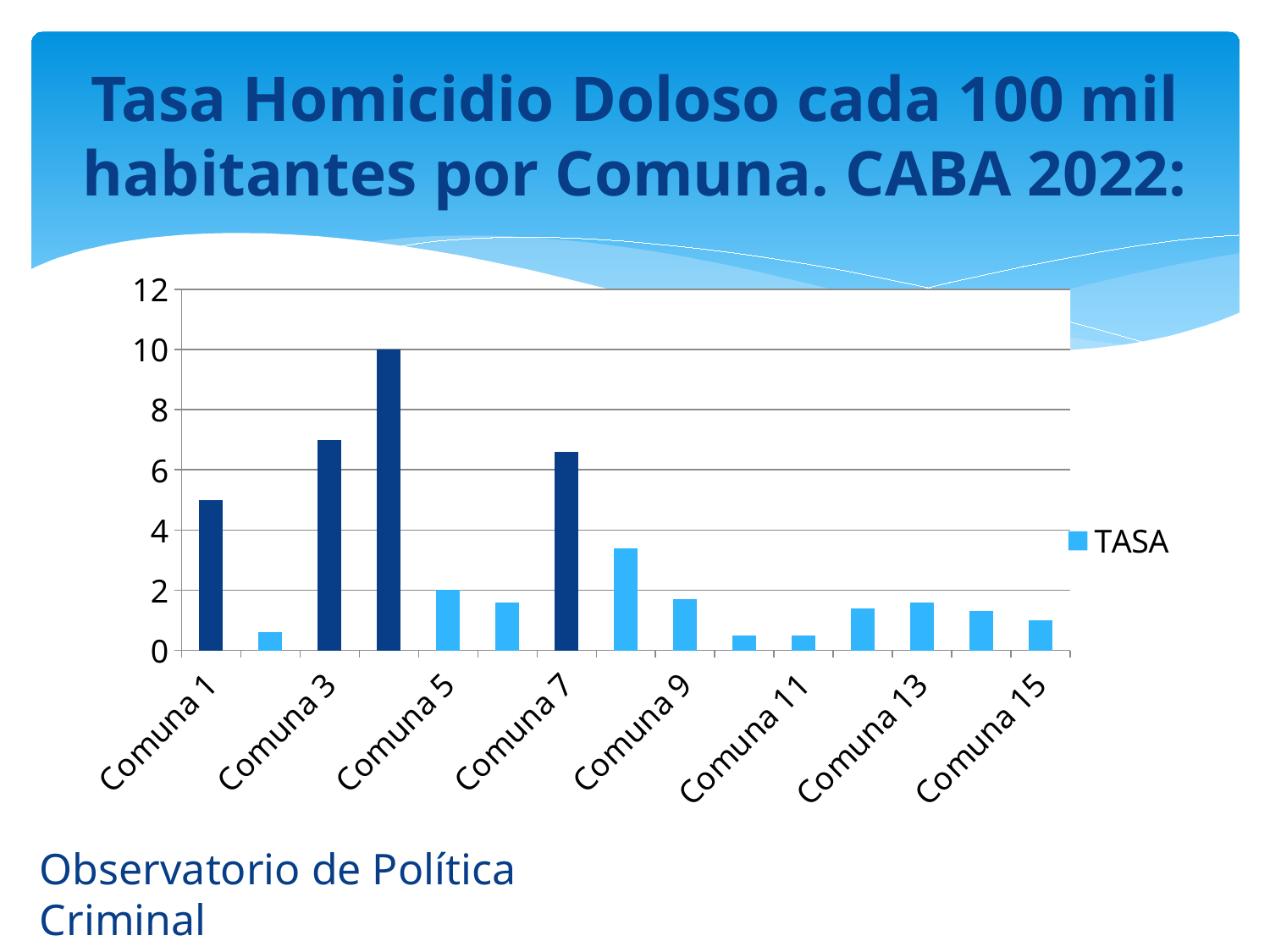
Is the value for Comuna 8 greater or less than 4? less How many comunas (categories) are plotted in the chart? 15 Which comuna has the highest homicide rate in the chart? Comuna 4 Which has a larger value, Comuna 1 or Comuna 8? Comuna 1 Is the value for Comuna 3 greater or less than 6? greater What kind of chart is shown on the slide? bar chart Which has a larger value, Comuna 3 or Comuna 1? Comuna 3 Is the value for Comuna 1 greater or less than 4? greater How many series does the legend list? 1 What is the title of the chart on the slide? Tasa Homicidio Doloso cada 100 mil habitantes por Comuna. CABA 2022: What is the name of the series shown in the legend? TASA